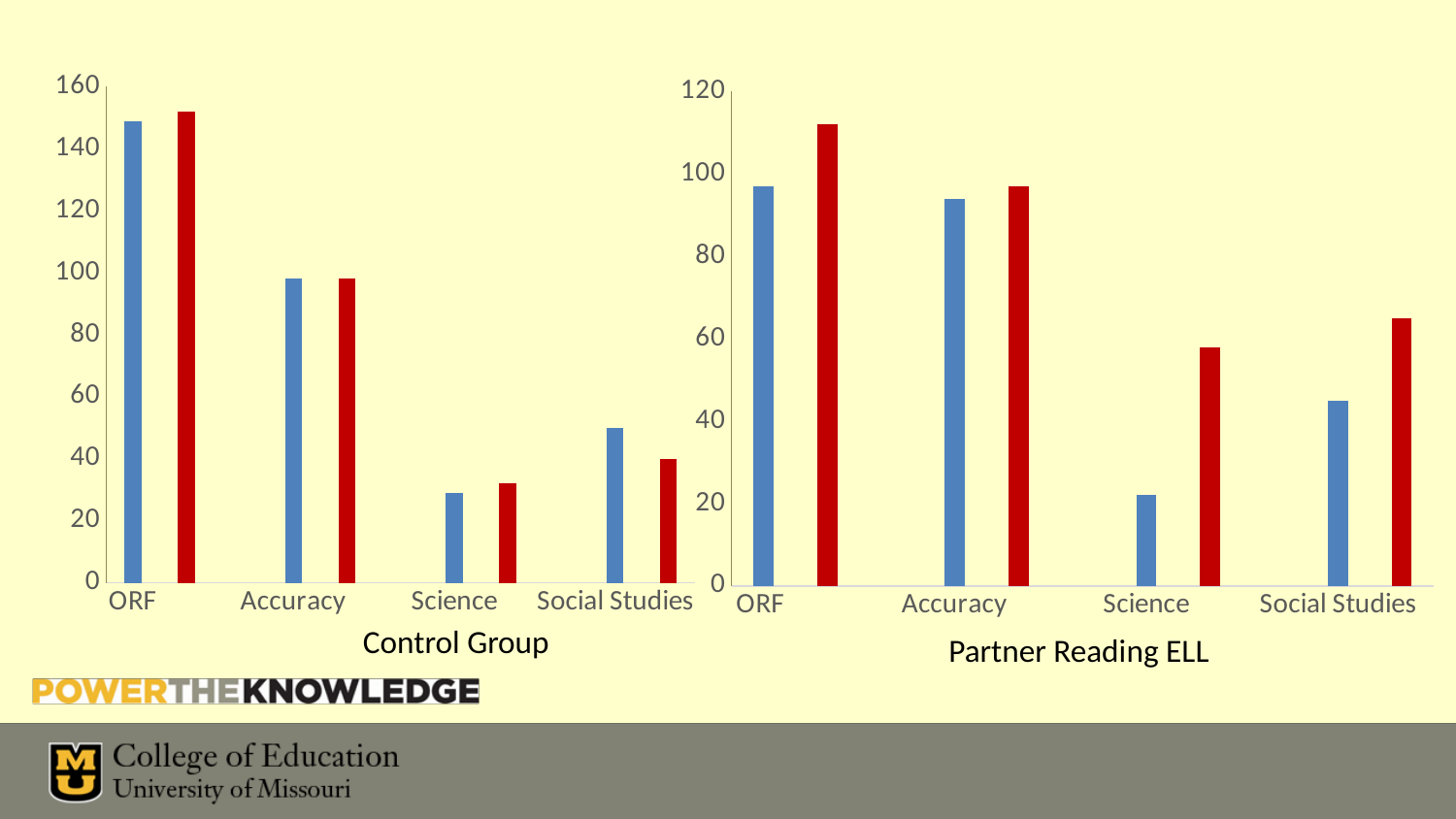
What is the title of the chart on the right side of the slide? Partner Reading ELL In the Partner Reading ELL chart, which category has the tallest bars? ORF In the Control Group chart, which category has the shortest bars? Science In the Partner Reading ELL chart, is the blue bar for Accuracy greater or less than 100? less In the Control Group chart, is the blue bar for ORF greater or less than 140? greater What kind of chart is the Control Group chart? bar chart In the Partner Reading ELL chart, which category has the shortest blue bar? Science In the Partner Reading ELL chart, for Science, which bar is taller, the blue bar or the red bar? the red bar How many categories are shown on the x axis of the Partner Reading ELL chart? 4 In the Partner Reading ELL chart, is the red bar for ORF greater or less than 100? greater In the Control Group chart, which category has the tallest bars? ORF